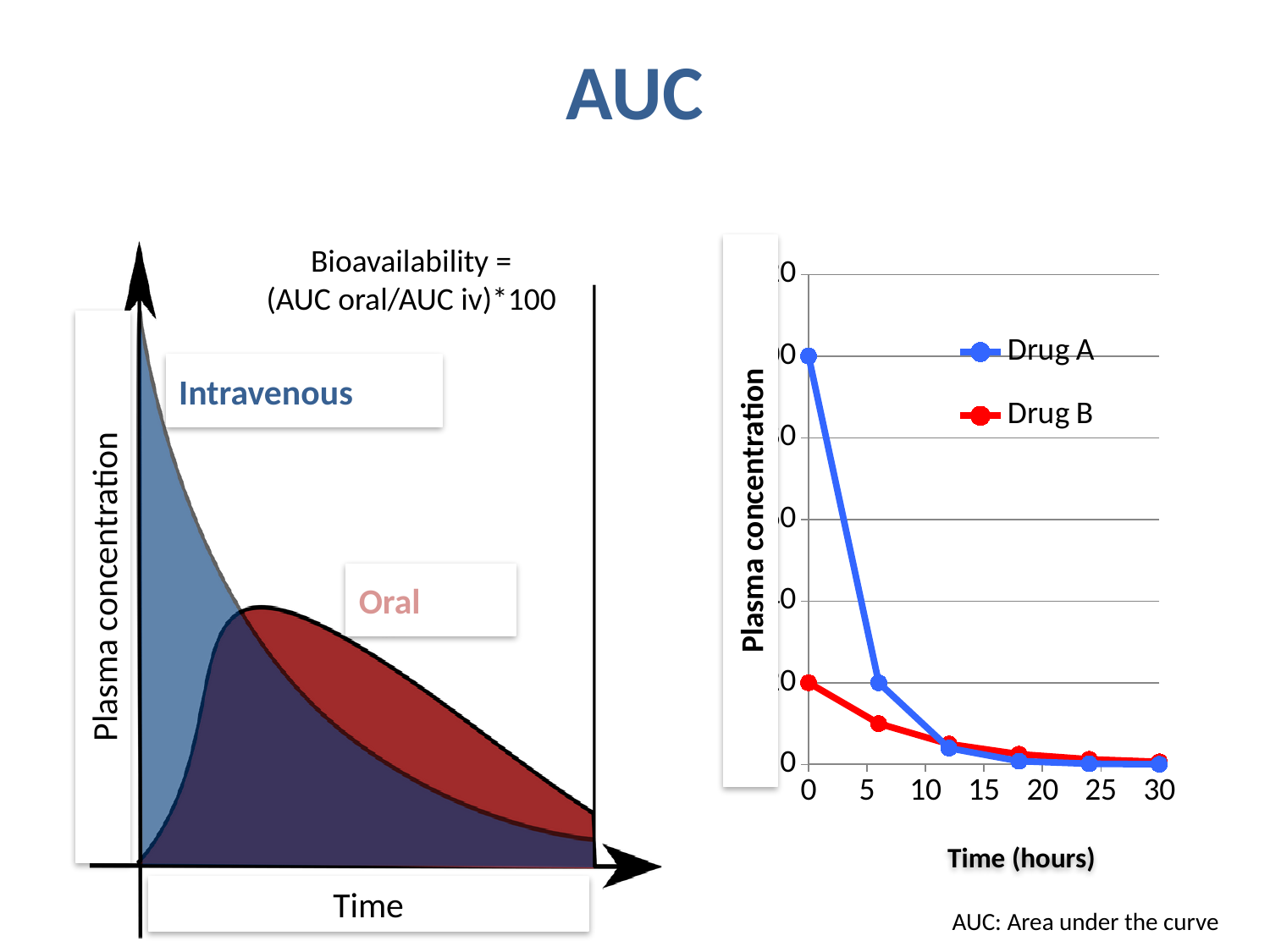
In the chart on the left, which curve has the higher peak plasma concentration, Intravenous or Oral? Intravenous In the chart on the right, does the plasma concentration of Drug A rise or fall as time increases? fall In the chart on the right, what is the title of the x axis? Time (hours) In the chart on the right, at 0 hours, which series has the higher plasma concentration, Drug A or Drug B? Drug A In the chart on the right, does the plasma concentration of Drug B rise or fall as time increases? fall In the chart on the left, which curve starts at its maximum at time zero, Intravenous or Oral? Intravenous In the chart on the right, how many data points are plotted for Drug A? 6 In the chart on the right, how many series does the legend list? 2 In the chart on the right, what are the two series named in the legend? Drug A and Drug B In the chart on the right, at 5 hours, which series has the higher plasma concentration, Drug A or Drug B? Drug A What kind of chart is the chart on the right of the slide? line chart In the chart on the right, at which time (in hours) does Drug A reach its highest plasma concentration? 0